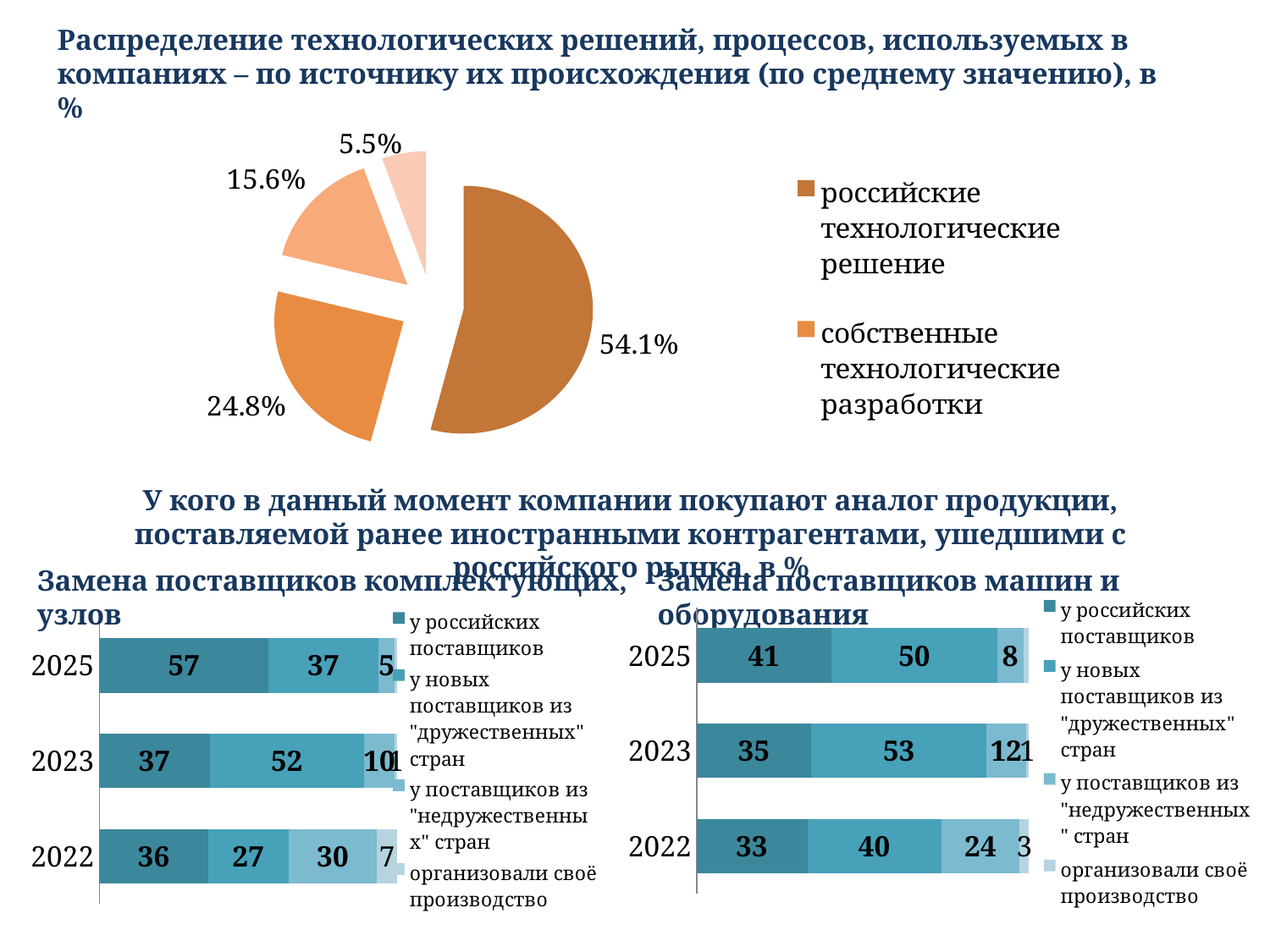
In the chart 'Замена поставщиков комплектующих, узлов', what is the value for у новых поставщиков из "дружественных" стран in 2023? 52 In the chart 'Замена поставщиков комплектующих, узлов', which year has the larger value for у российских поставщиков, 2025 or 2023? 2025 How many series does the legend of the chart 'Замена поставщиков комплектующих, узлов' list? 4 In the chart 'Замена поставщиков комплектующих, узлов', what is the value for у российских поставщиков in 2022? 36 In the chart 'Замена поставщиков машин и оборудования', what is the difference between the 2025 and 2022 values for у российских поставщиков? 8 In the chart 'Замена поставщиков машин и оборудования', what is the value for у поставщиков из "недружественных" стран in 2022? 24 In the pie chart, what share is shown for российские технологические решение? 54.1% What kind of chart is the top chart on the slide? pie chart In the pie chart, which category has the largest slice? российские технологические решение In the chart 'Замена поставщиков машин и оборудования', what is the value for у новых поставщиков из "дружественных" стран in 2025? 50 In the pie chart, what share is shown for собственные технологические разработки? 24.8% How many slices does the pie chart have? 4